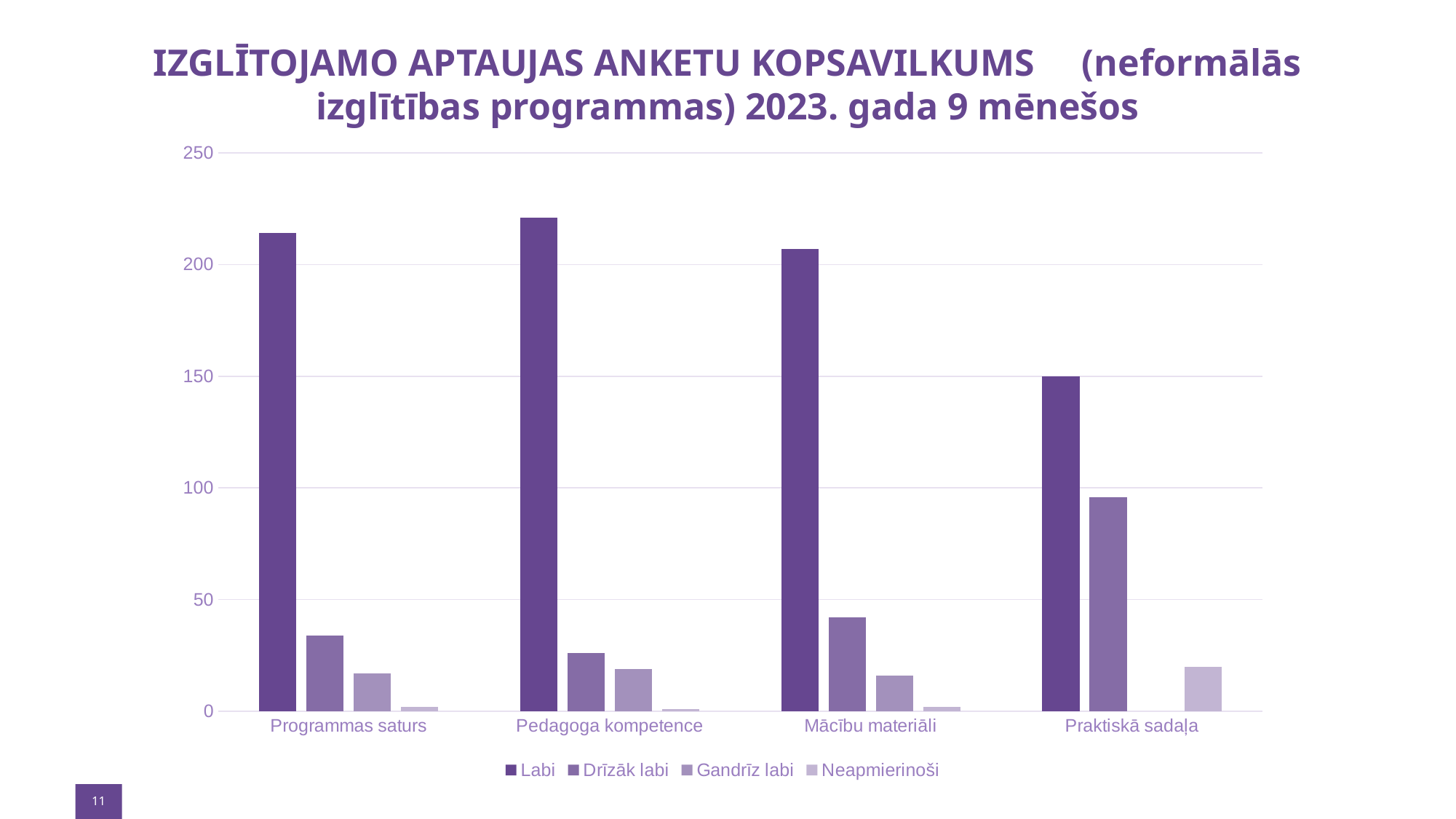
Which is larger: the Drīzāk labi value for Mācību materiāli or for Programmas saturs? Mācību materiāli Is the Labi value for Praktiskā sadaļa greater or less than 200? less Is the Drīzāk labi value for Praktiskā sadaļa greater or less than 50? greater Which category has the highest value for the Drīzāk labi series? Praktiskā sadaļa Which category has the highest value for the Labi series? Pedagoga kompetence What is the first entry listed in the legend? Labi Is the Neapmierinoši value for Praktiskā sadaļa greater or less than 50? less How many series does the legend list? 4 How many categories are shown on the x axis? 4 What kind of chart is shown on the slide? bar chart Which category has the lowest value for the Labi series? Praktiskā sadaļa